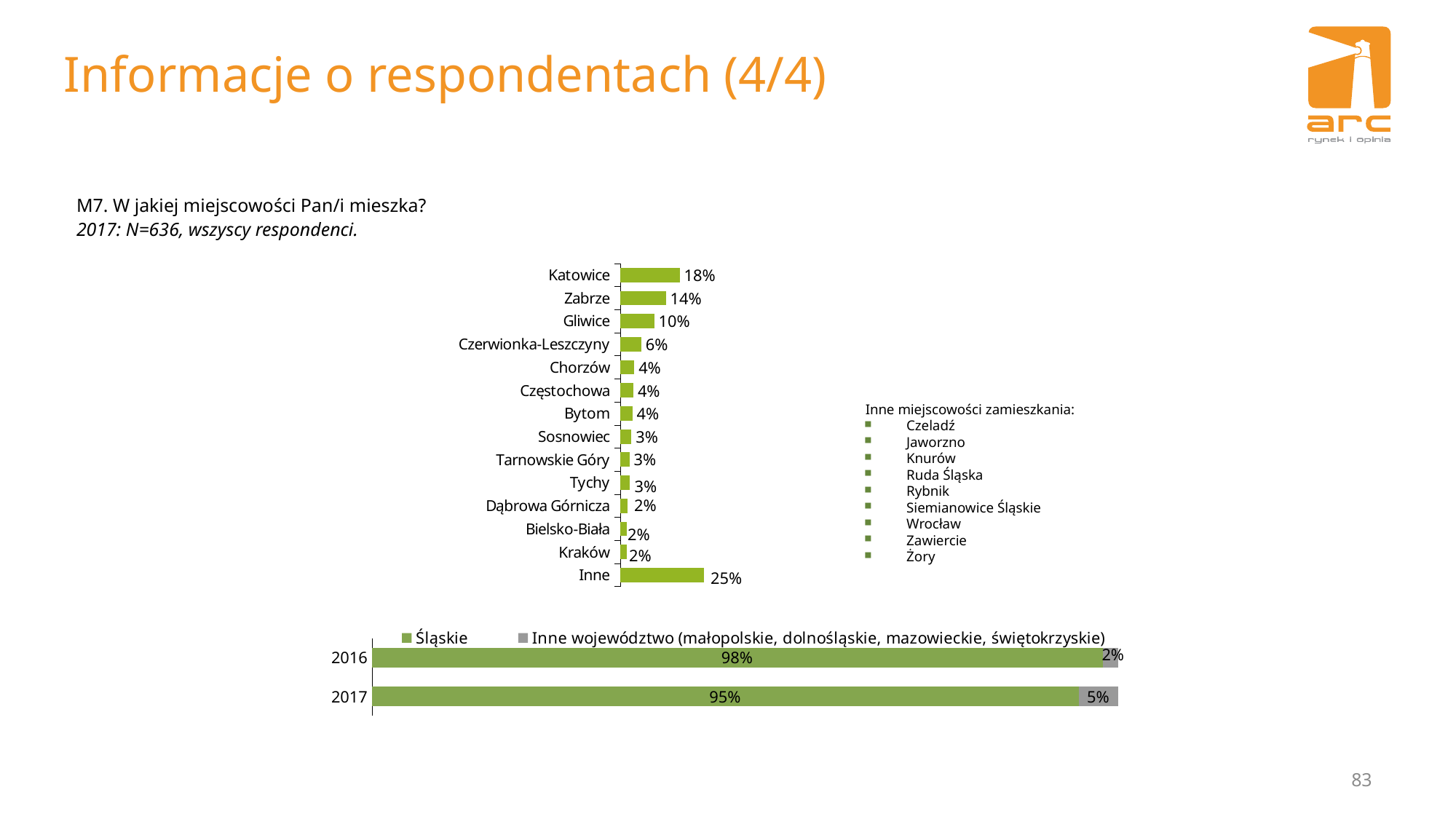
In the top chart of cities, what is the value for Inne? 25% In the top chart of cities, how many categories are plotted? 14 In the bottom chart by year, what is the value for Śląskie in 2017? 95% In the bottom chart by year, how many series does the legend list? 2 In the top chart of cities, which named city (excluding Inne) has the highest value? Katowice In the top chart of cities, what is the difference between the values for Katowice and Zabrze? 4% In the top chart of cities, what is the value for Gliwice? 10% What kind of chart is the bottom chart by year? Stacked bar chart In the top chart of cities, which is larger, the value for Zabrze or the value for Gliwice? Zabrze In the top chart of cities, what is the value for Katowice? 18% In the top chart of cities, what is the value for Czerwionka-Leszczyny? 6% In the bottom chart by year, what is the value for Inne województwo in 2016? 2%